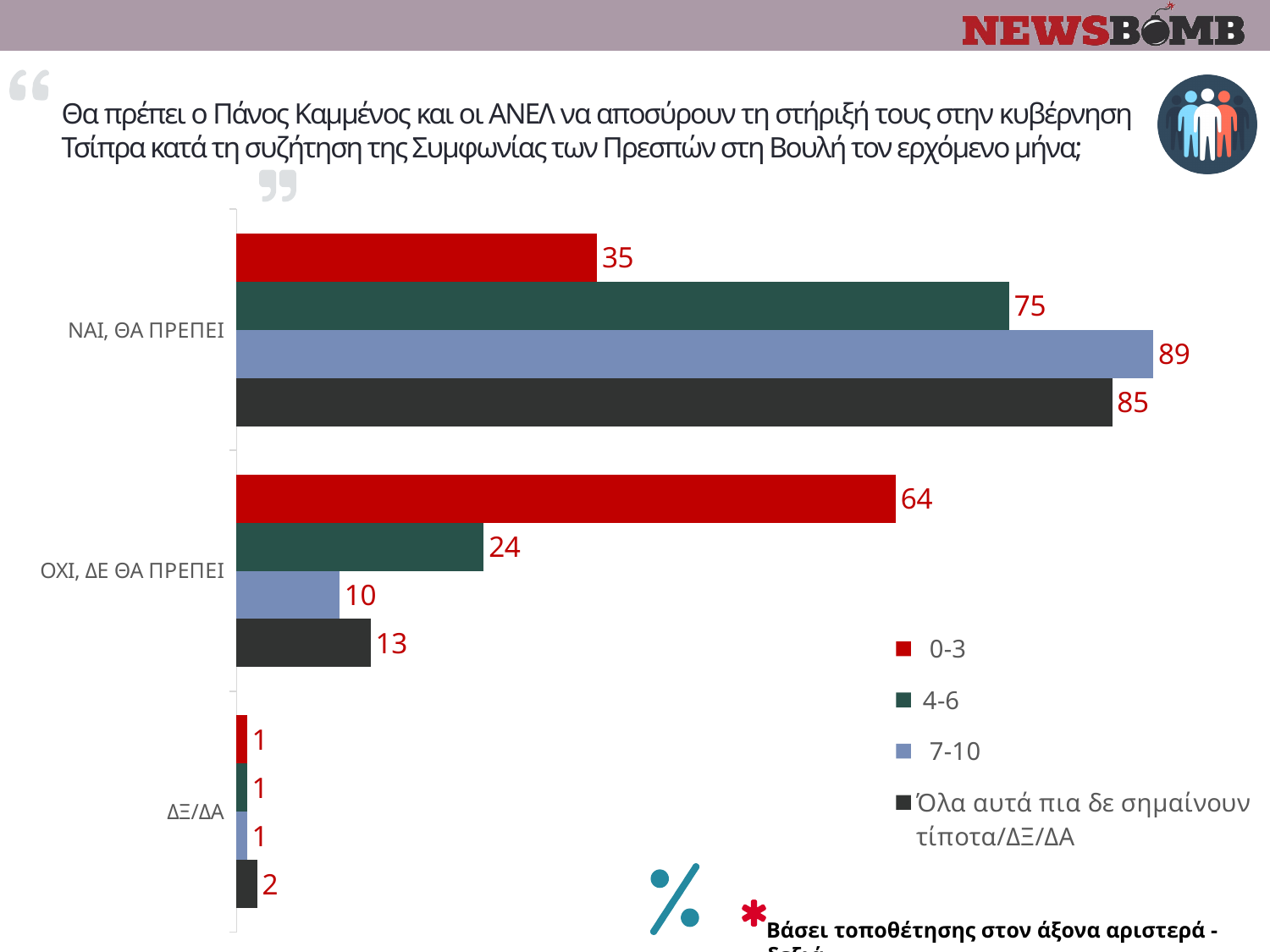
What is the difference between the 0-3 values for ΟΧΙ, ΔΕ ΘΑ ΠΡΕΠΕΙ and ΝΑΙ, ΘΑ ΠΡΕΠΕΙ? 29 What is the value for the 7-10 series in the ΝΑΙ, ΘΑ ΠΡΕΠΕΙ category? 89 Which series has the highest value in the ΝΑΙ, ΘΑ ΠΡΕΠΕΙ category? 7-10 How many series does the legend list? 4 What kind of chart is shown on the slide? Bar chart Which series has the lowest value in the ΟΧΙ, ΔΕ ΘΑ ΠΡΕΠΕΙ category? 7-10 How many categories are shown on the chart? 3 What is the value for the 4-6 series in the ΝΑΙ, ΘΑ ΠΡΕΠΕΙ category? 75 What is the value for the Όλα αυτά πια δε σημαίνουν τίποτα/ΔΞ/ΔΑ series in the ΔΞ/ΔΑ category? 2 Which is larger: the 4-6 value for ΝΑΙ, ΘΑ ΠΡΕΠΕΙ or the 4-6 value for ΟΧΙ, ΔΕ ΘΑ ΠΡΕΠΕΙ? ΝΑΙ, ΘΑ ΠΡΕΠΕΙ What is the value for the 0-3 series in the ΟΧΙ, ΔΕ ΘΑ ΠΡΕΠΕΙ category? 64 What colour represents the 0-3 series in the legend? Red